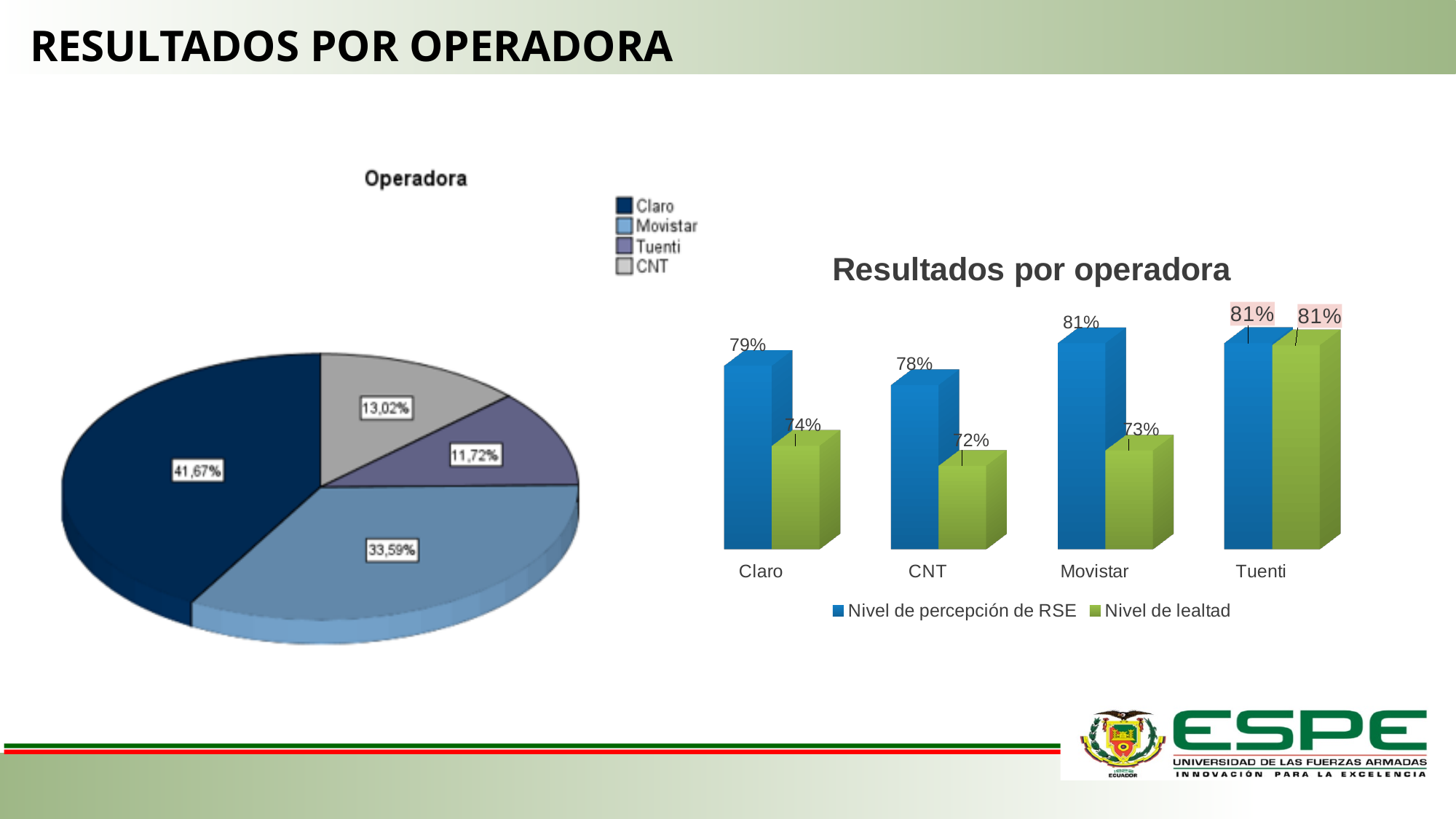
In the bar chart titled 'Resultados por operadora', which operator has the highest Nivel de lealtad? Tuenti In the pie chart titled 'Operadora', what share does Movistar have? 33,59% In the bar chart titled 'Resultados por operadora', which operator has the lowest Nivel de percepción de RSE? CNT In the bar chart titled 'Resultados por operadora', how many series does the legend list? 2 In the pie chart titled 'Operadora', which operator has the smallest slice? Tuenti In the bar chart titled 'Resultados por operadora', what is the difference between the Nivel de percepción de RSE and the Nivel de lealtad for Movistar? 8% What type of chart is the chart titled 'Resultados por operadora'? Bar chart In the pie chart titled 'Operadora', which is larger, the CNT slice or the Tuenti slice? CNT In the pie chart titled 'Operadora', how many slices are there? 4 In the bar chart titled 'Resultados por operadora', what is the Nivel de percepción de RSE for Claro? 79% In the pie chart titled 'Operadora', what share does Claro have? 41,67% In the bar chart titled 'Resultados por operadora', what is the Nivel de lealtad for CNT? 72%